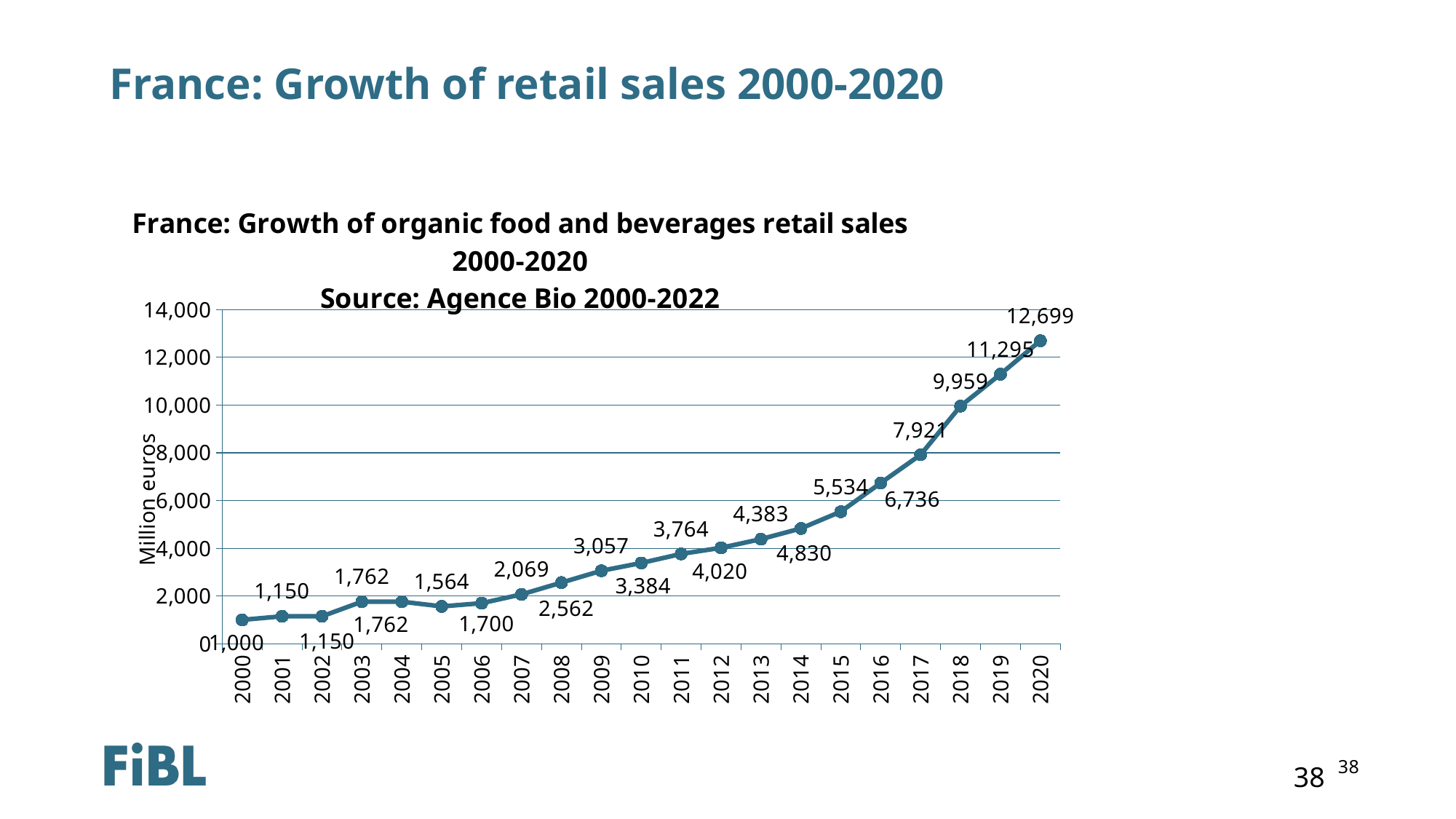
What was the value for 2016? 6,736 Which year has the lowest value on the chart? 2000 What type of chart is shown on the slide? line chart What was the value of organic food and beverages retail sales in France in 2020? 12,699 Is the value for 2015 greater or less than 6,000? less What was the value for 2005? 1,564 Which year has the highest value on the chart? 2020 What unit is shown on the vertical axis label? Million euros What is the difference between the values for 2020 and 2019? 1,404 What is the difference between the values for 2018 and 2017? 2,038 How many years (data points) are plotted on the chart? 21 What was the value for 2010? 3,384